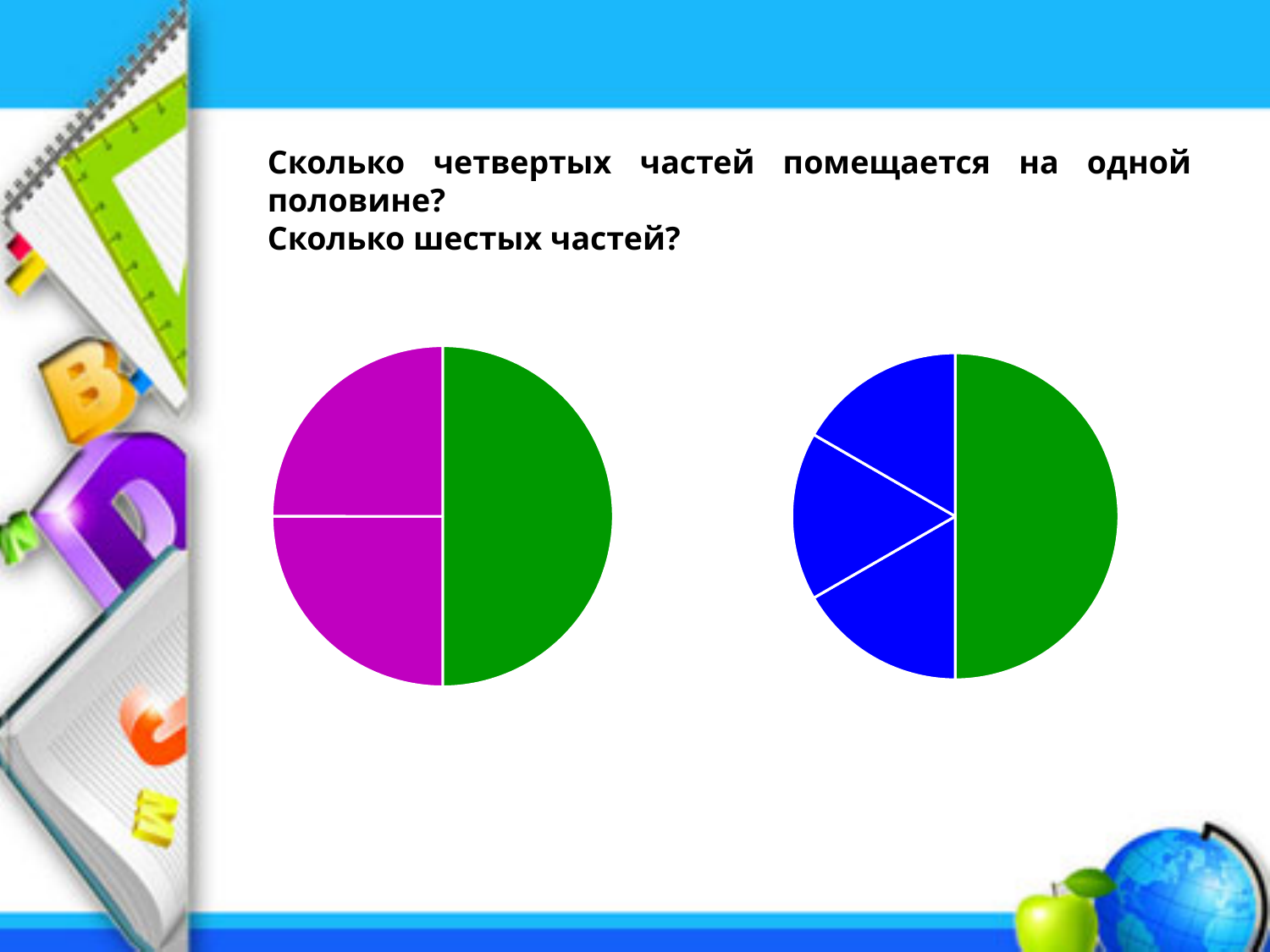
In the left pie chart, which is larger: the green slice or one purple slice? the green slice In the right pie chart, how many slices are there in total? 4 In the right pie chart, which is larger: the green slice or one blue slice? the green slice In the right pie chart, which colour slice is the largest? green Which two colours are used in the left pie chart? green and purple In the left pie chart, how many slices are there in total? 3 In the left pie chart, which colour slice is the largest? green What kind of chart is the right chart on the slide? pie chart What kind of chart is the left chart on the slide? pie chart In the left pie chart, how many purple slices are there? 2 Which two colours are used in the right pie chart? green and blue